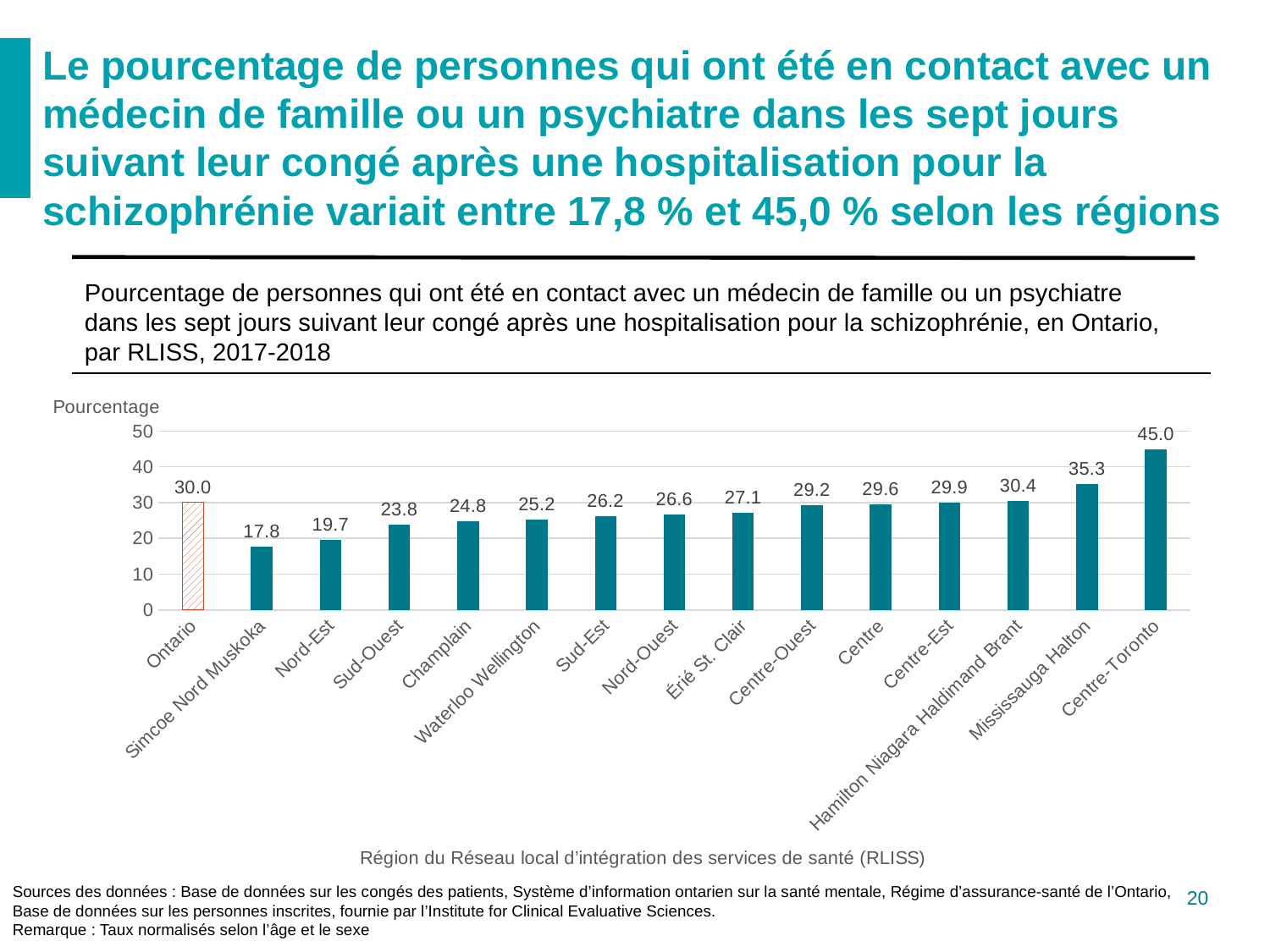
What is the value for Ontario? 30.0 What is the value for Mississauga Halton? 35.3 How many bars are shown in the chart? 15 Which region has the lowest value? Simcoe Nord Muskoka Do the values for the RLISS regions rise or fall from left to right after the Ontario bar? Rise What kind of chart is shown on the slide? Bar chart Is the value for Centre-Est greater or less than 30? less Which is larger, the value for Nord-Est or the value for Sud-Ouest? Sud-Ouest What is the label of the y axis? Pourcentage What is the value for Champlain? 24.8 Which region has the highest value? Centre-Toronto What is the difference between the values for Centre-Toronto and Simcoe Nord Muskoka? 27.2